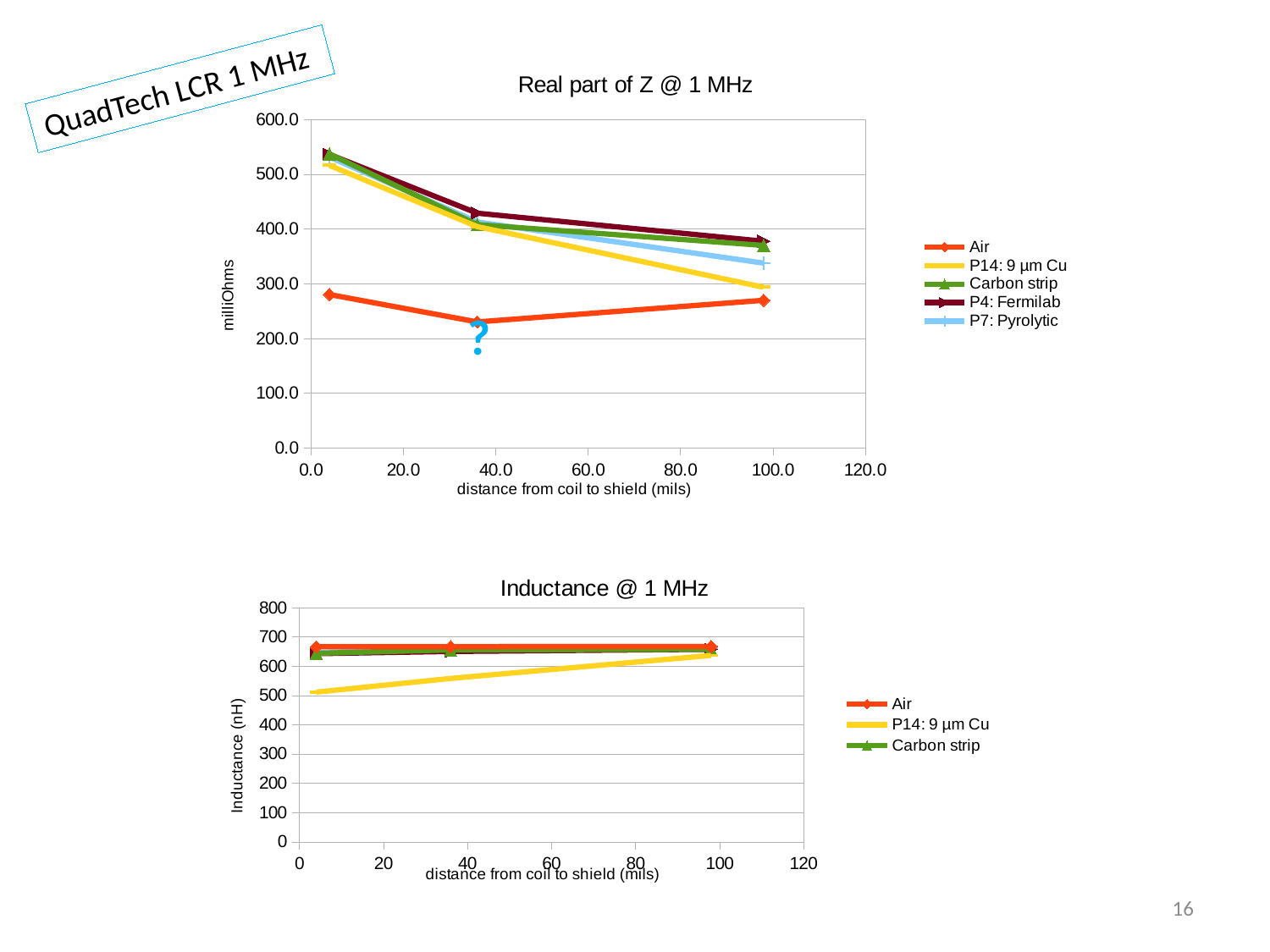
In the "Real part of Z @ 1 MHz" chart, how many series does the legend list? 5 In the "Real part of Z @ 1 MHz" chart, how many data points does the Air series have? 3 In the "Real part of Z @ 1 MHz" chart, does the P14: 9 µm Cu series rise or fall as distance increases? fall In the "Real part of Z @ 1 MHz" chart, what kind of chart is shown? line chart In the "Real part of Z @ 1 MHz" chart, at the largest distance, which is larger: P4: Fermilab or Air? P4: Fermilab In the "Real part of Z @ 1 MHz" chart, is the value for P14: 9 µm Cu at the largest distance greater or less than 200? greater In the "Inductance @ 1 MHz" chart, how many series does the legend list? 3 In the "Inductance @ 1 MHz" chart, is the value for Air at the smallest distance greater or less than 600? greater In the "Real part of Z @ 1 MHz" chart, is the value for P4: Fermilab at the smallest distance greater or less than 500? greater In the "Inductance @ 1 MHz" chart, does the P14: 9 µm Cu series rise or fall as distance increases? rise In the "Real part of Z @ 1 MHz" chart, at the largest distance, which is larger: Carbon strip or P14: 9 µm Cu? Carbon strip